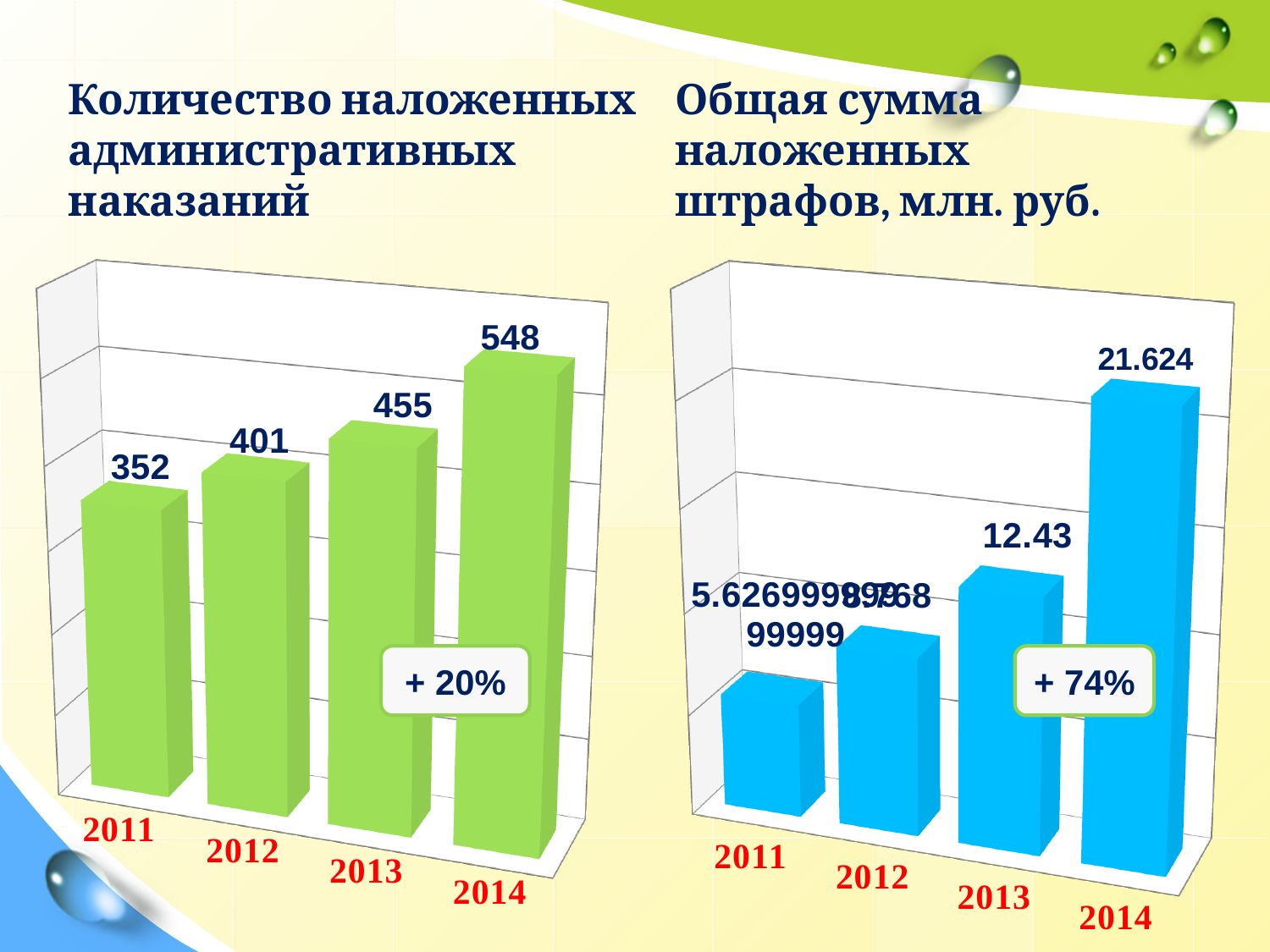
On the left chart (Количество наложенных административных наказаний), what is the value for 2013? 455 On the right chart (Общая сумма наложенных штрафов, млн. руб.), what is the value for 2013? 12.43 On the left chart (Количество наложенных административных наказаний), which year has the highest value? 2014 On the right chart (Общая сумма наложенных штрафов, млн. руб.), what is the value for 2014? 21.624 On the right chart (Общая сумма наложенных штрафов, млн. руб.), which year has the highest value? 2014 On the left chart (Количество наложенных административных наказаний), which year has the lowest value? 2011 On the left chart (Количество наложенных административных наказаний), what is the value for 2011? 352 On the left chart (Количество наложенных административных наказаний), what is the difference between the 2014 and 2011 values? 196 What kind of chart is the right chart (Общая сумма наложенных штрафов, млн. руб.)? bar chart On the left chart (Количество наложенных административных наказаний), how many years are shown? 4 On the left chart (Количество наложенных административных наказаний), do the values rise or fall from 2011 to 2014? rise On the right chart (Общая сумма наложенных штрафов, млн. руб.), which is larger, the value for 2012 or the value for 2013? 2013